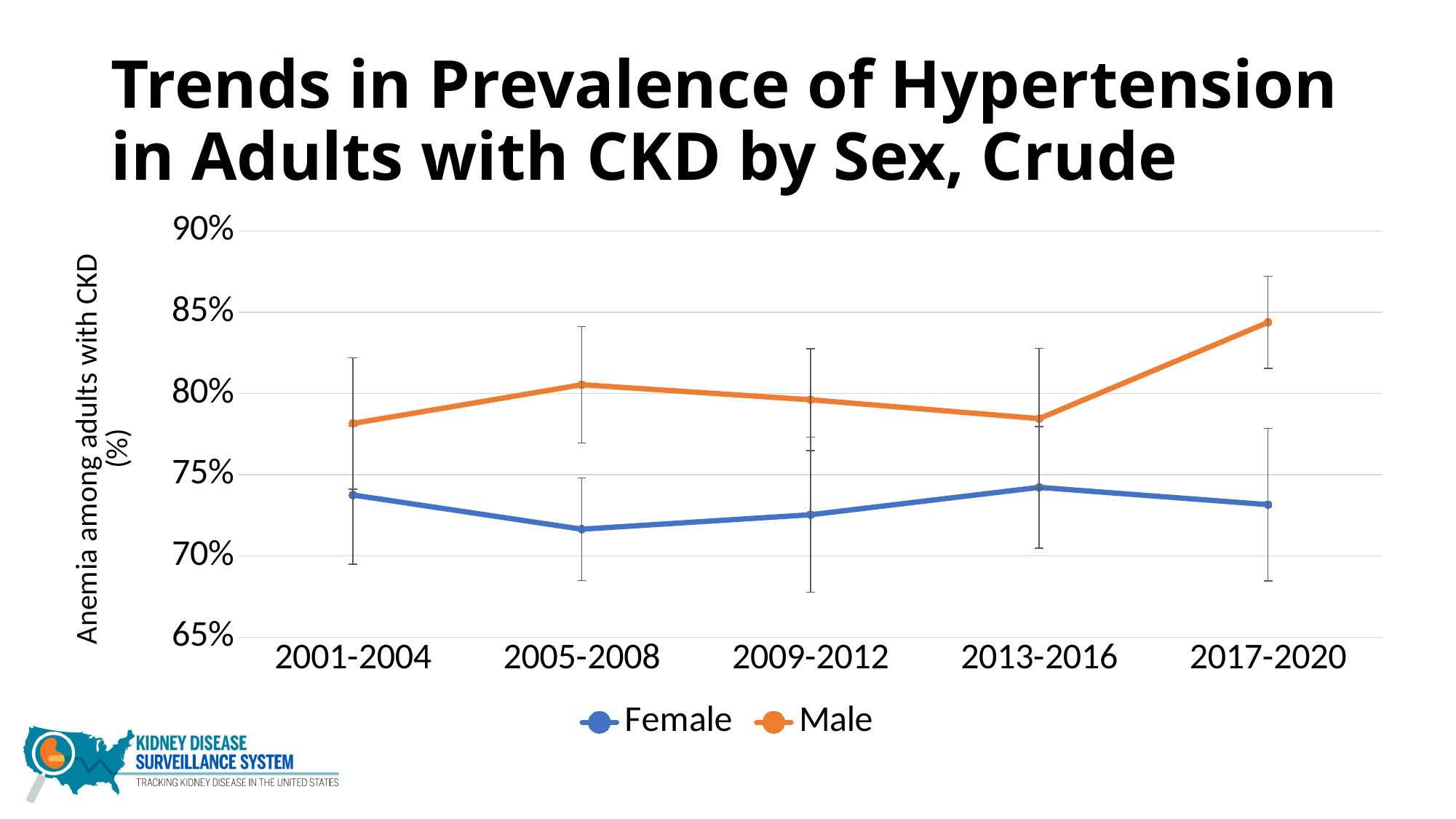
How many time periods are shown on the x axis? 5 Is the value for Female in 2005-2008 greater or less than 75%? less Is the value for Male in 2001-2004 greater or less than 75%? greater In 2017-2020, which series has the larger value, Female or Male? Male In which period is the Male value highest? 2017-2020 In which period is the Female value lowest? 2005-2008 Is the value for Male in 2017-2020 greater or less than 80%? greater What colour is the Male series line? orange Does the Male line rise or fall from 2013-2016 to 2017-2020? rise What kind of chart is shown on the slide? line chart How many series does the legend list? 2